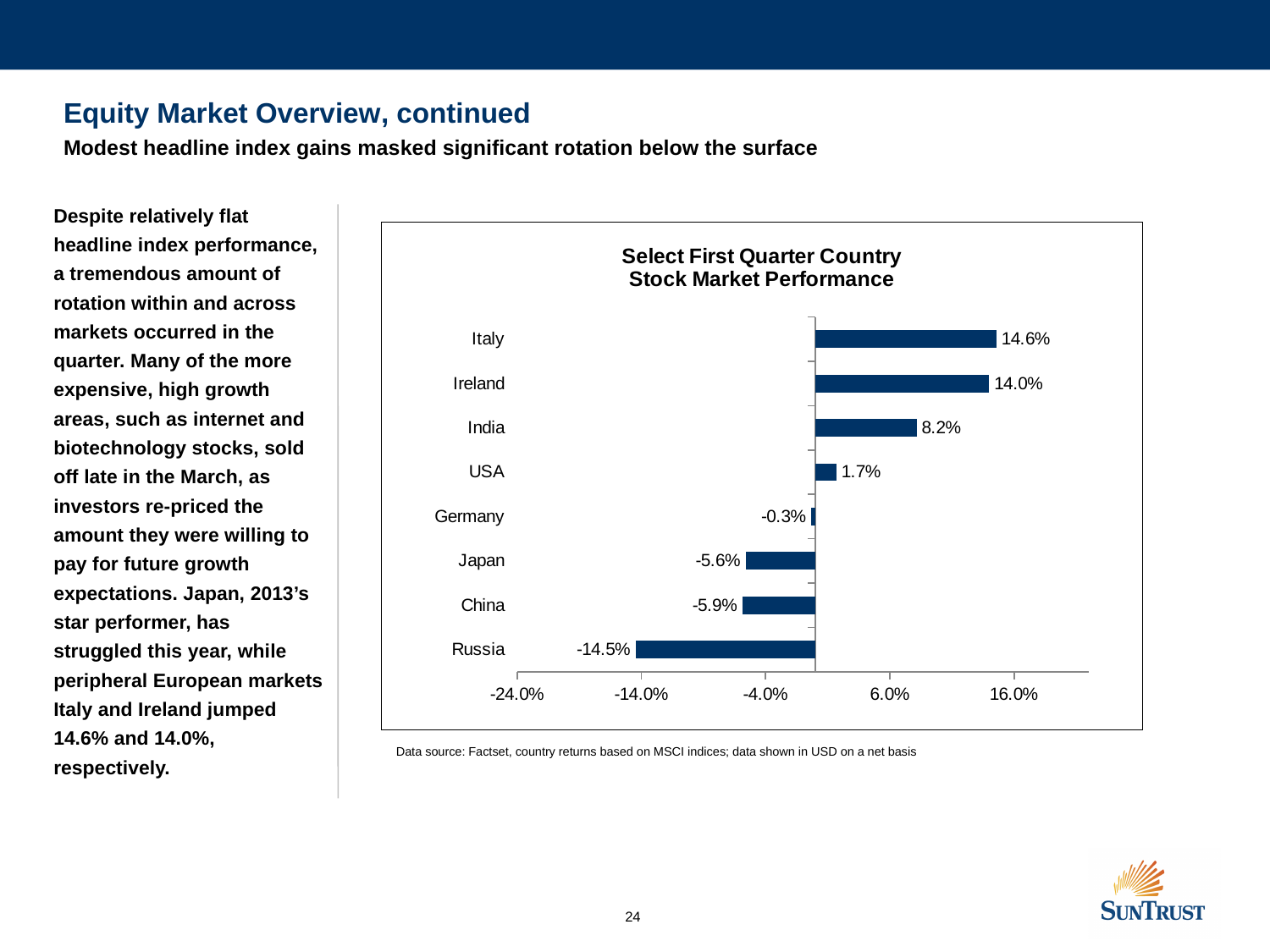
What is the value shown for India? 8.2% What is the title of the chart? Select First Quarter Country Stock Market Performance What is the value shown for Russia? -14.5% What is the first quarter stock market performance for Italy? 14.6% Which country has the lowest first quarter performance? Russia What is the difference between Italy's and Ireland's values? 0.6% Which has the larger value, Japan or China? Japan What is the value shown for the USA? 1.7% What kind of chart is shown on the slide? Bar chart Which country has the highest first quarter performance? Italy How many countries are shown in the chart? 8 What is the value shown for Germany? -0.3%